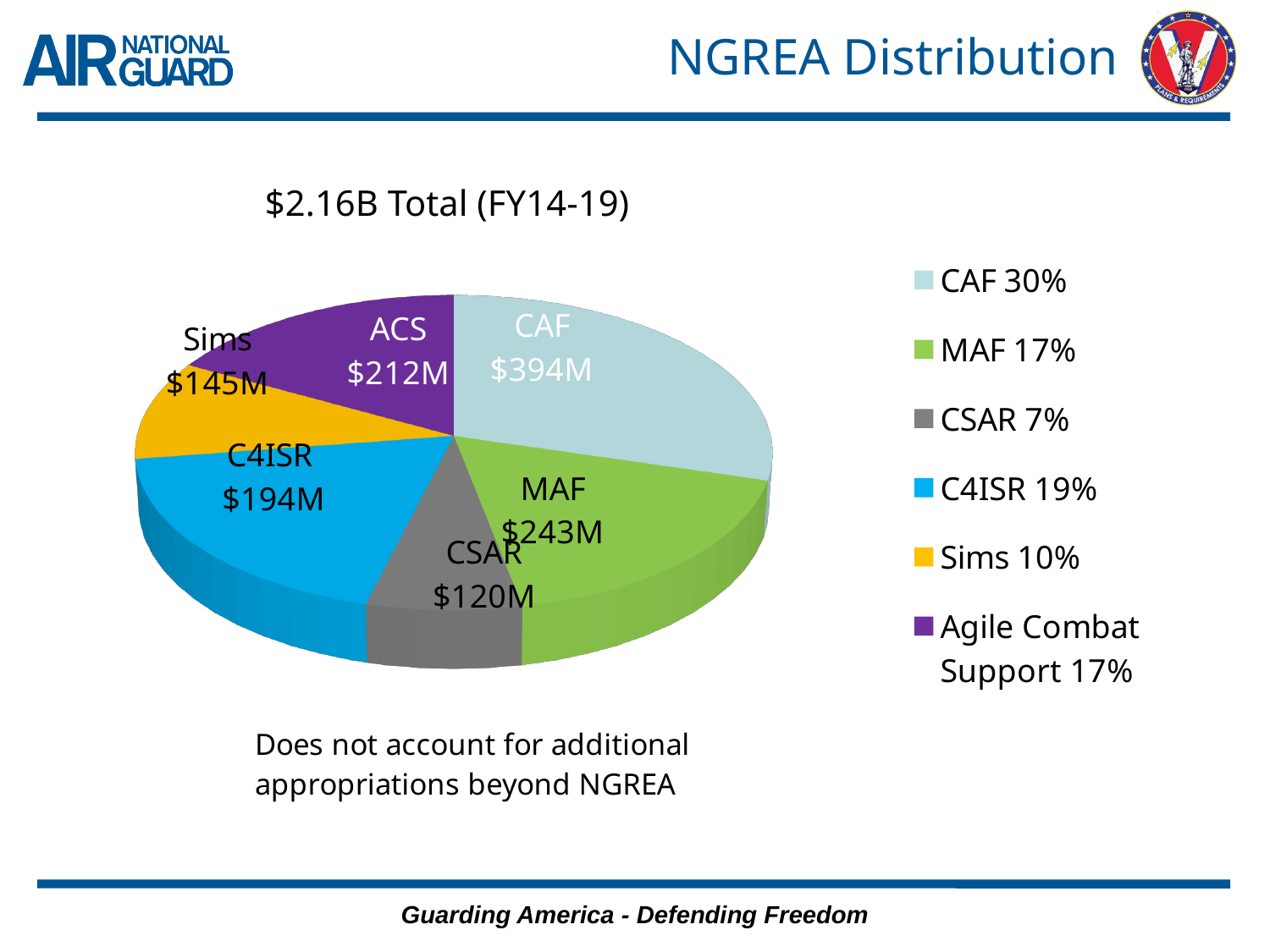
What is the difference between the CAF value and the MAF value? $151M What kind of chart is shown on the slide? Pie chart Which is larger, the value for Sims or the value for ACS? ACS What is the value shown for CAF in the pie chart? $394M Which category has the largest slice of the pie chart? CAF What is the title shown above the pie chart? $2.16B Total (FY14-19) Which category has the smallest slice of the pie chart? CSAR What is the value shown for C4ISR in the pie chart? $194M How many slices does the pie chart have? 6 According to the legend, what share of the pie does C4ISR represent? 19% What is the value shown for CSAR in the pie chart? $120M According to the legend, what share of the pie does Sims represent? 10%